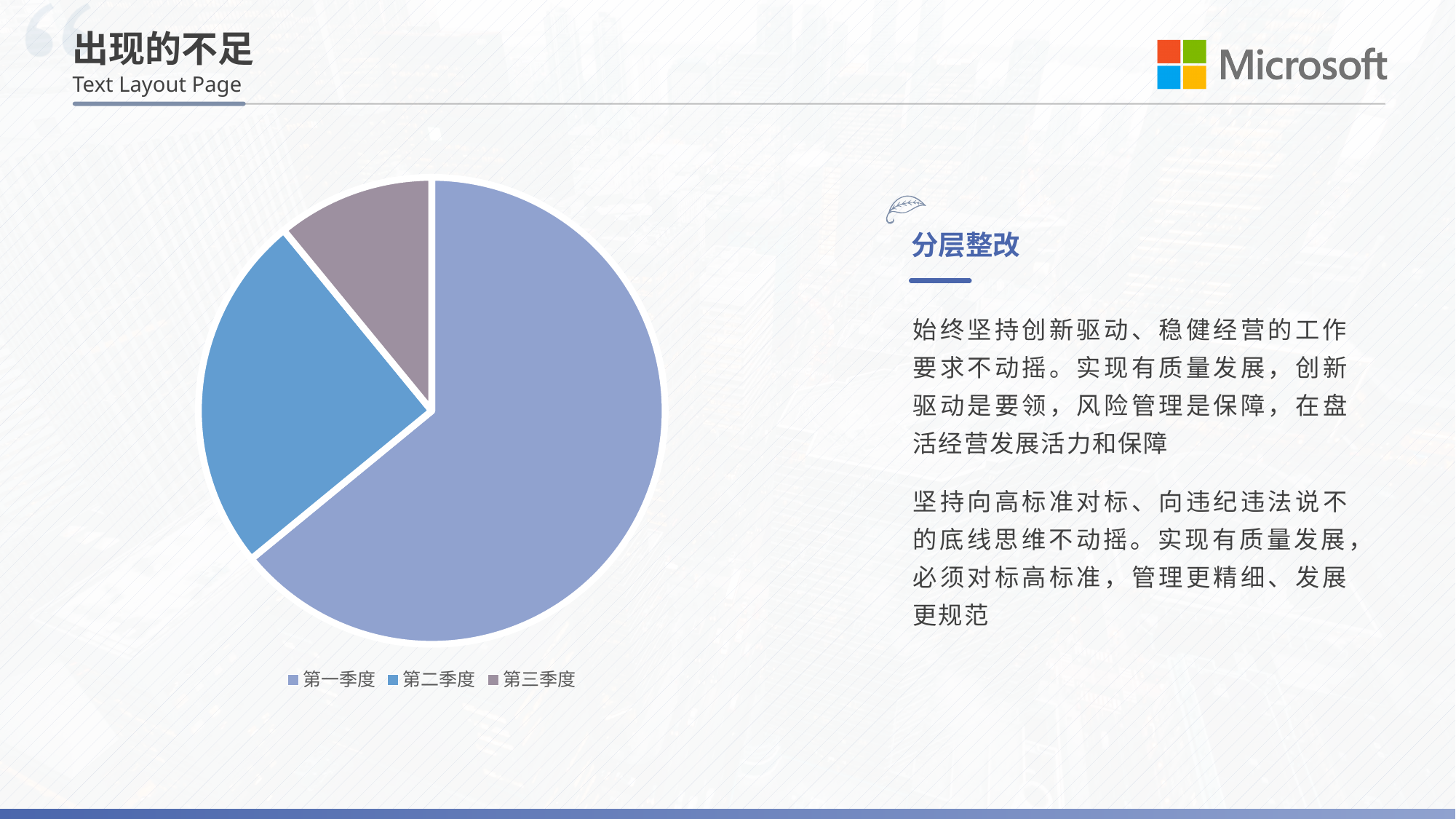
Which category is shown in the brighter blue colour in the pie chart? 第二季度 Which slice is larger, 第一季度 or 第二季度? 第一季度 What are the three categories listed in the pie chart's legend, in order? 第一季度, 第二季度, 第三季度 Which category has the largest slice in the pie chart? 第一季度 Which category has the smallest slice in the pie chart? 第三季度 How many slices does the pie chart have? 3 How many entries does the legend of the pie chart list? 3 Which slice is larger, 第二季度 or 第三季度? 第二季度 What kind of chart is shown on the slide? pie chart Does the 第一季度 slice take up more or less than half of the pie? more